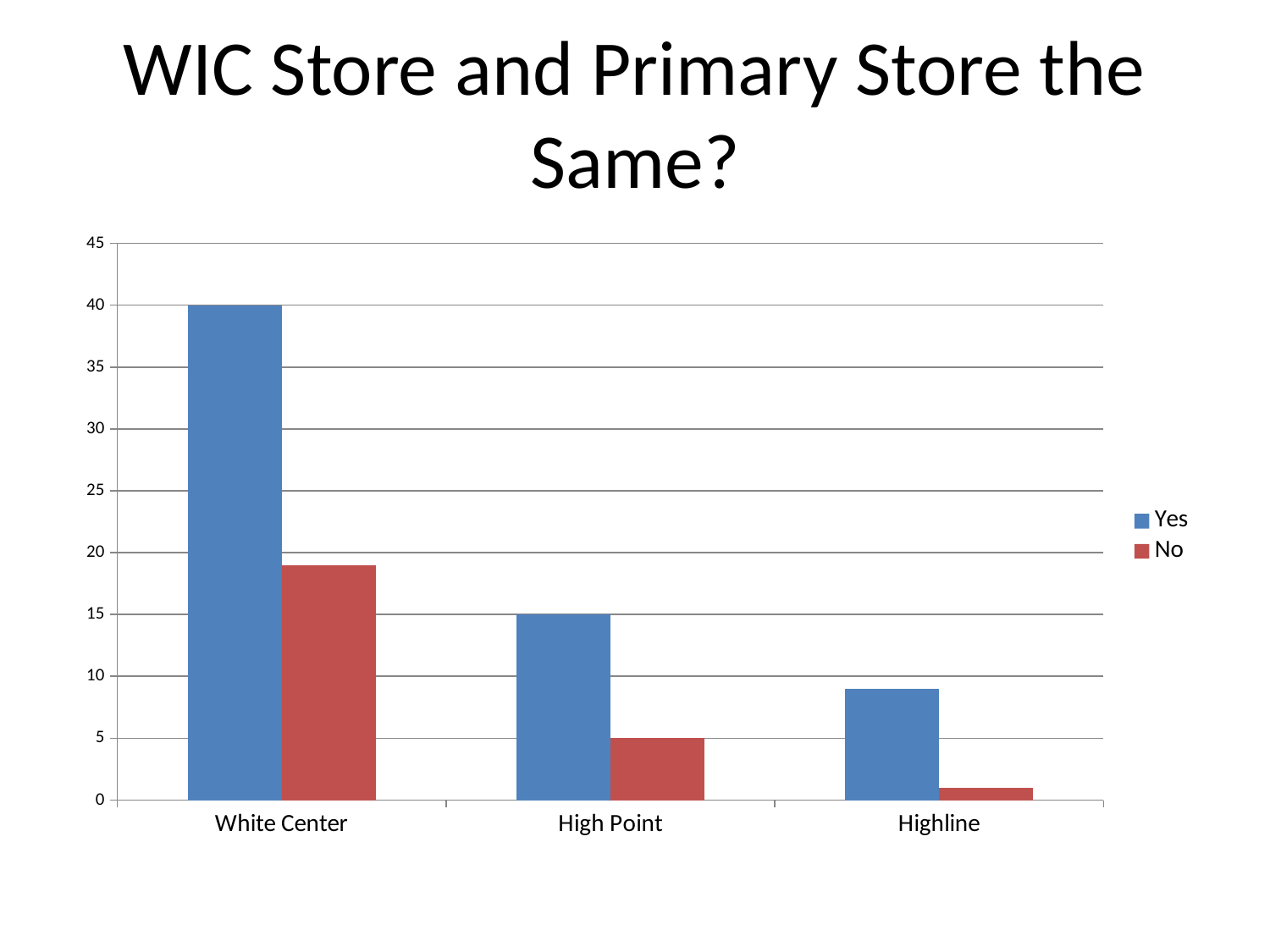
Is the No value for White Center greater or less than 15? greater Which category has the highest Yes value? White Center Do the Yes values rise or fall from White Center to Highline along the x axis? fall Which category has the lowest No value? Highline How many categories are shown on the x axis? 3 What type of chart is shown on the slide? bar chart Is the Yes value for Highline greater or less than 10? less What is the Yes value for High Point? 15 What is the No value for High Point? 5 What is the Yes value for White Center? 40 What is the difference between the Yes values for White Center and High Point? 25 How many series does the legend list? 2